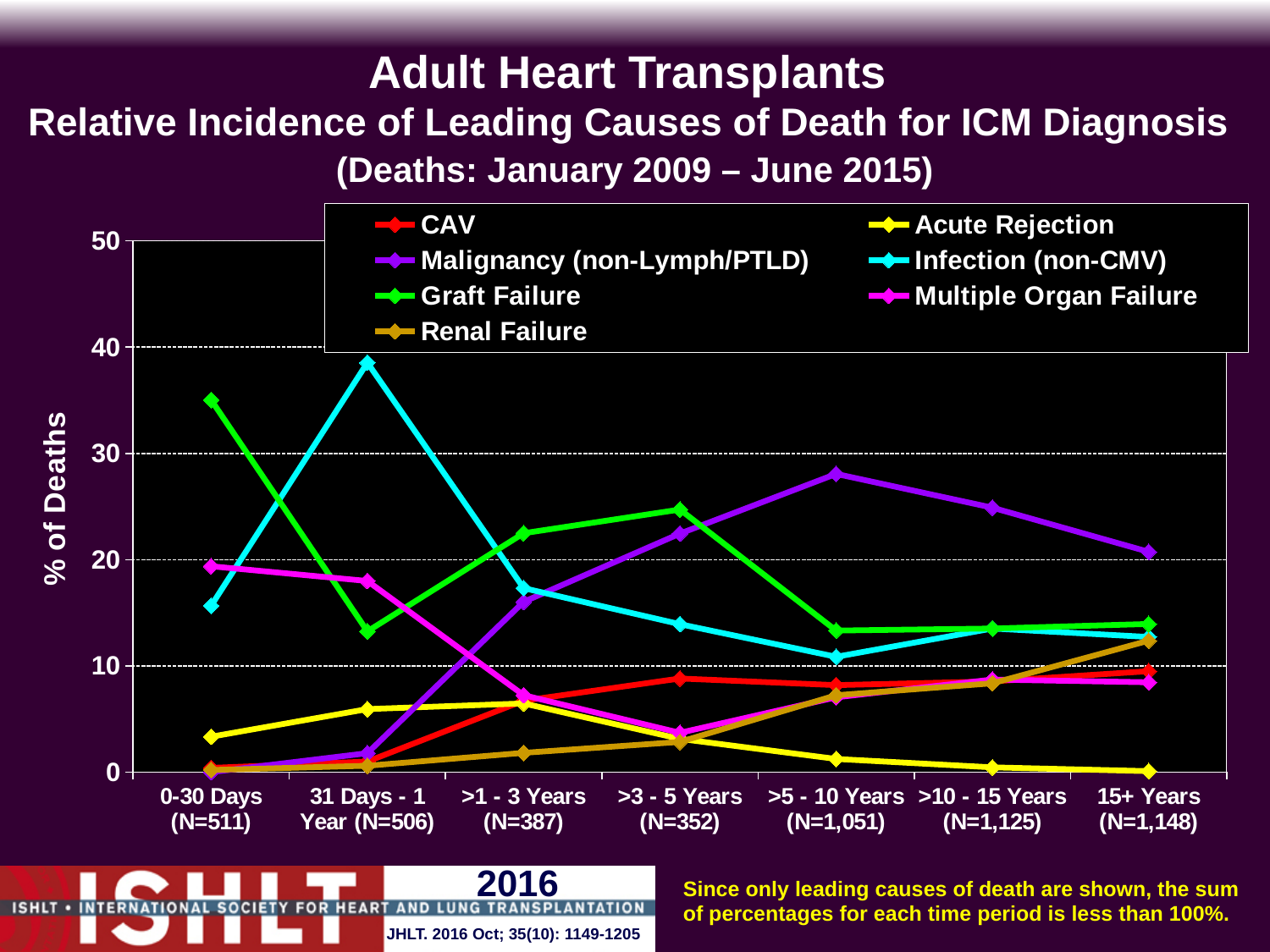
In the >5 - 10 Years period, which is larger: Malignancy (non-Lymph/PTLD) or Infection (non-CMV)? Malignancy (non-Lymph/PTLD) How many time periods are shown along the x axis? 7 Which cause of death has the lowest percentage in the 15+ Years period? Acute Rejection Is the value for Malignancy (non-Lymph/PTLD) in the >5 - 10 Years period greater or less than 20? greater What kind of chart is shown on the slide? line chart What is the label on the y axis? % of Deaths Which cause of death has the highest percentage in the >5 - 10 Years period? Malignancy (non-Lymph/PTLD) Which cause of death has the highest percentage in the 31 Days - 1 Year period? Infection (non-CMV) How many causes of death does the legend list? 7 Is the value for Infection (non-CMV) in the 31 Days - 1 Year period greater or less than 30? greater Which cause of death has the highest percentage in the 0-30 Days period? Graft Failure Does the Renal Failure line rise or fall from the 0-30 Days period to the 15+ Years period? rise